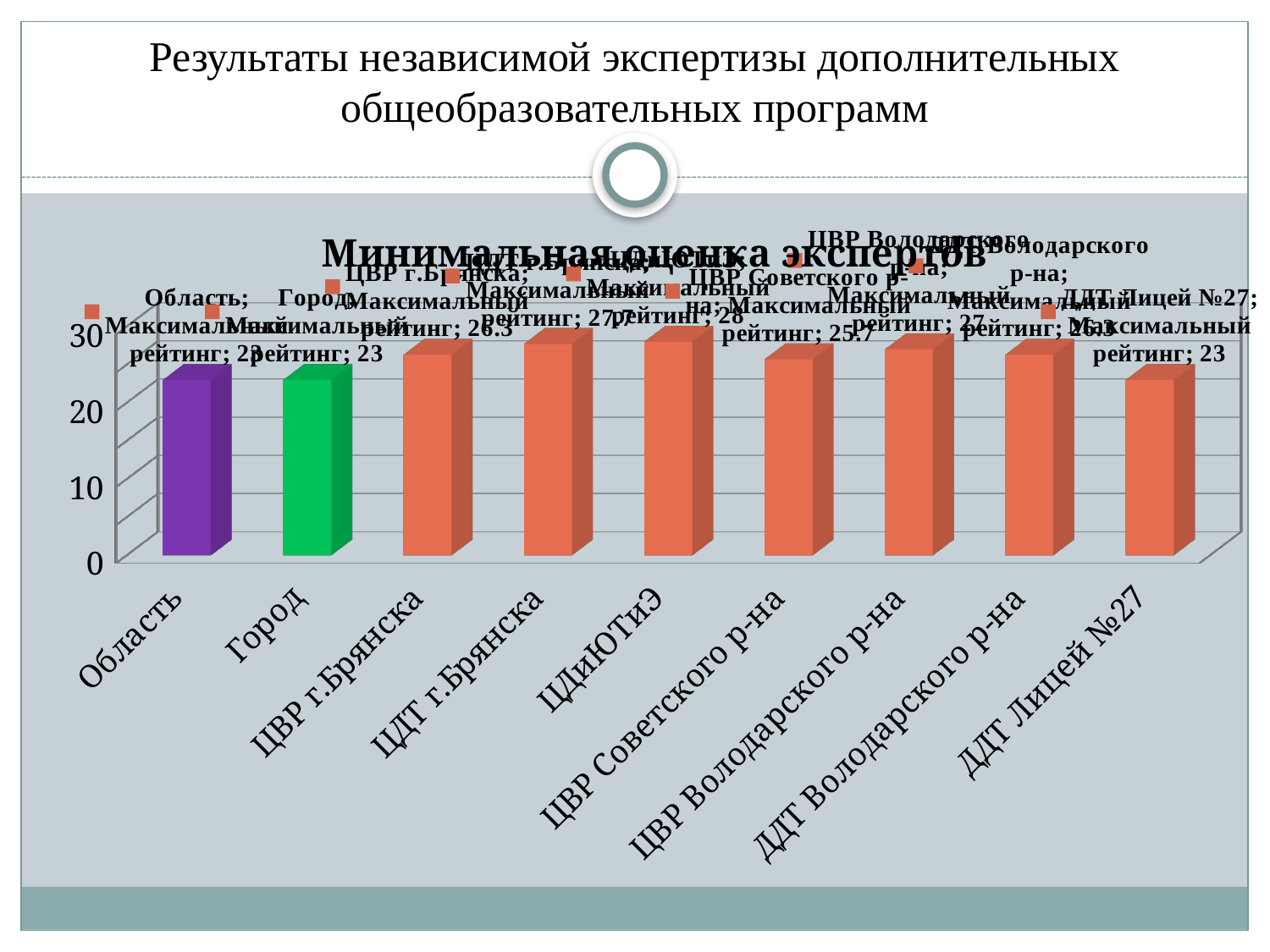
What is the value for Область? 23 Is the value for ДДТ Лицей №27 greater or less than 30? less What is the title of the chart? Минимальная оценка экспертов What is the difference between the values for ЦДиЮТиЭ and Область? 5 What kind of chart is shown on the slide? bar chart What is the value for ЦДТ г.Брянска? 27.7 What colour is the bar for Область? purple Which category has the highest value? ЦДиЮТиЭ How many categories are plotted on the x axis? 9 What is the value for ЦВР Советского р-на? 25.7 Which is larger, the value for ЦВР г.Брянска or the value for Город? ЦВР г.Брянска What is the value for ЦДиЮТиЭ? 28